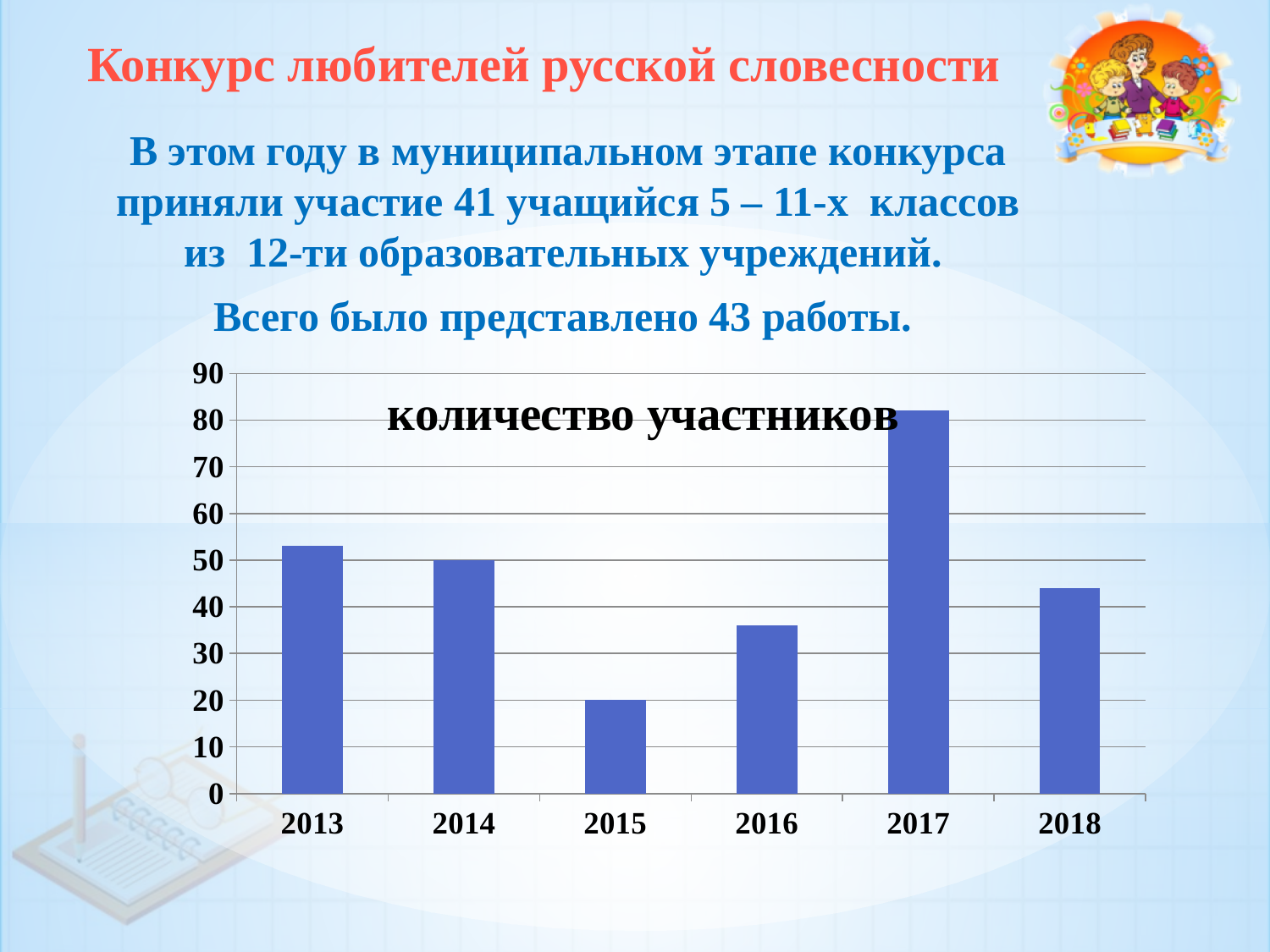
Which year has the highest number of participants? 2017 What is the number of participants in 2015? 20 What kind of chart is shown on the slide? bar chart Is the value for 2017 greater or less than 70? greater Is the value for 2016 greater or less than 40? less Which year has more participants, 2013 or 2016? 2013 What is the title of the chart? количество участников What is the number of participants in 2014? 50 Is the value for 2013 greater or less than 60? less Do the values rise or fall from 2013 to 2015? fall Which year has the lowest number of participants? 2015 How many years are shown on the x axis of the chart? 6